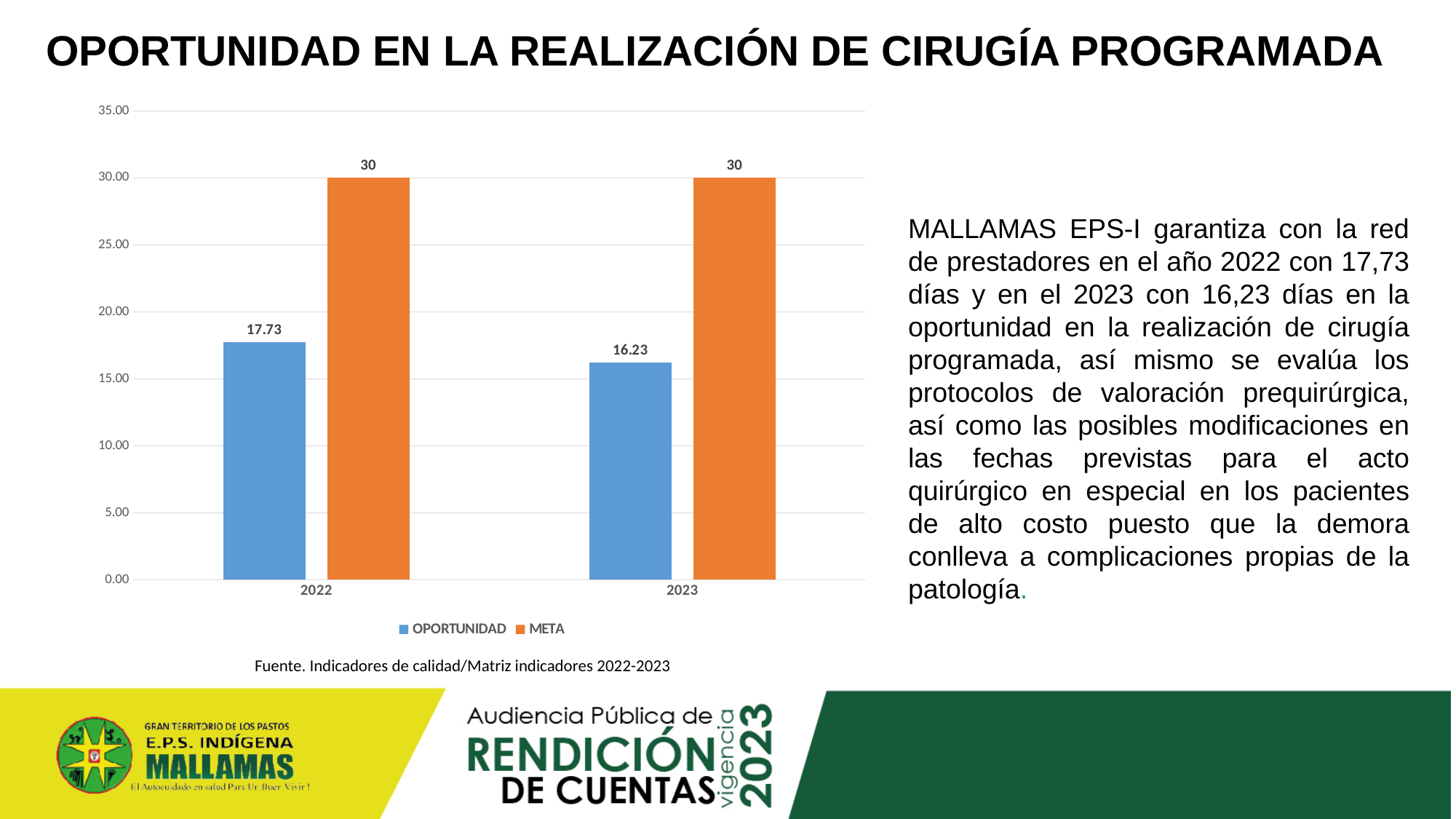
Is the OPORTUNIDAD value for 2023 greater or less than 20.00? less What is the difference between the META and OPORTUNIDAD values for 2023? 13.77 Which year has the lower OPORTUNIDAD value? 2023 What kind of chart is shown on the slide? bar chart What is the OPORTUNIDAD value for 2023? 16.23 Is the OPORTUNIDAD value for 2022 larger or smaller than the META value for 2022? smaller How many years are shown on the x axis? 2 How many series does the legend list? 2 What is the difference between the OPORTUNIDAD values for 2022 and 2023? 1.5 What is the META value for 2022? 30 Which year has the higher OPORTUNIDAD value? 2022 What is the OPORTUNIDAD value for 2022? 17.73